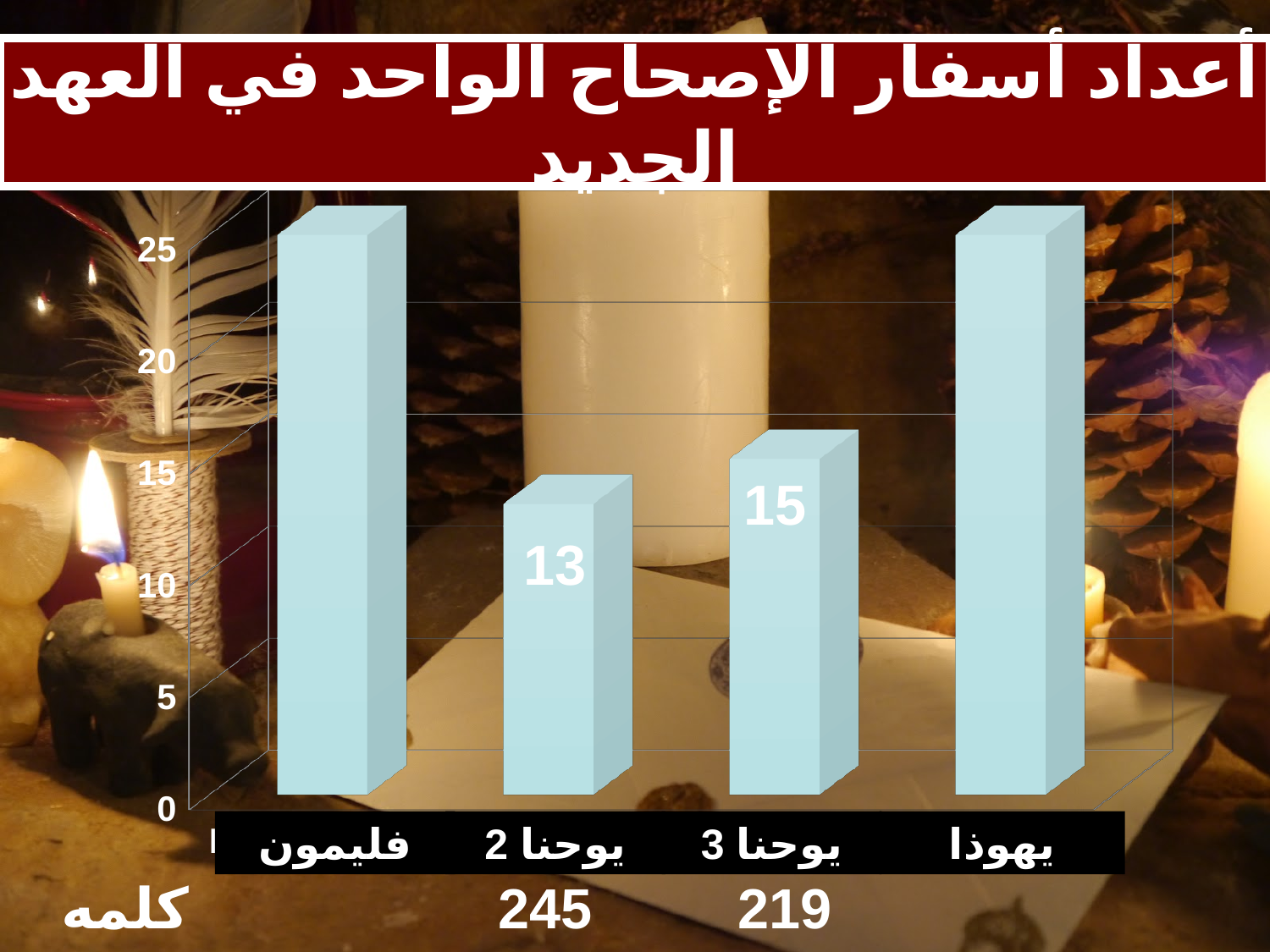
What is the value for يوحنا 3? 15 Is the value for فليمون greater or less than 20? greater Is the value for يوحنا 2 greater or less than 15? less What kind of chart is shown on the slide? bar chart Is the value for يهوذا greater or less than 20? greater What is the difference between the values for يوحنا 3 and يوحنا 2? 2 What is the value for يوحنا 2? 13 What is the title of the slide? أعداد أسفار الإصحاح الواحد في العهد الجديد Which is larger, the value for فليمون or the value for يوحنا 2? فليمون How many categories are shown on the chart? 4 Which category has the lowest value? يوحنا 2 Which is larger, the value for يوحنا 2 or the value for يوحنا 3? يوحنا 3